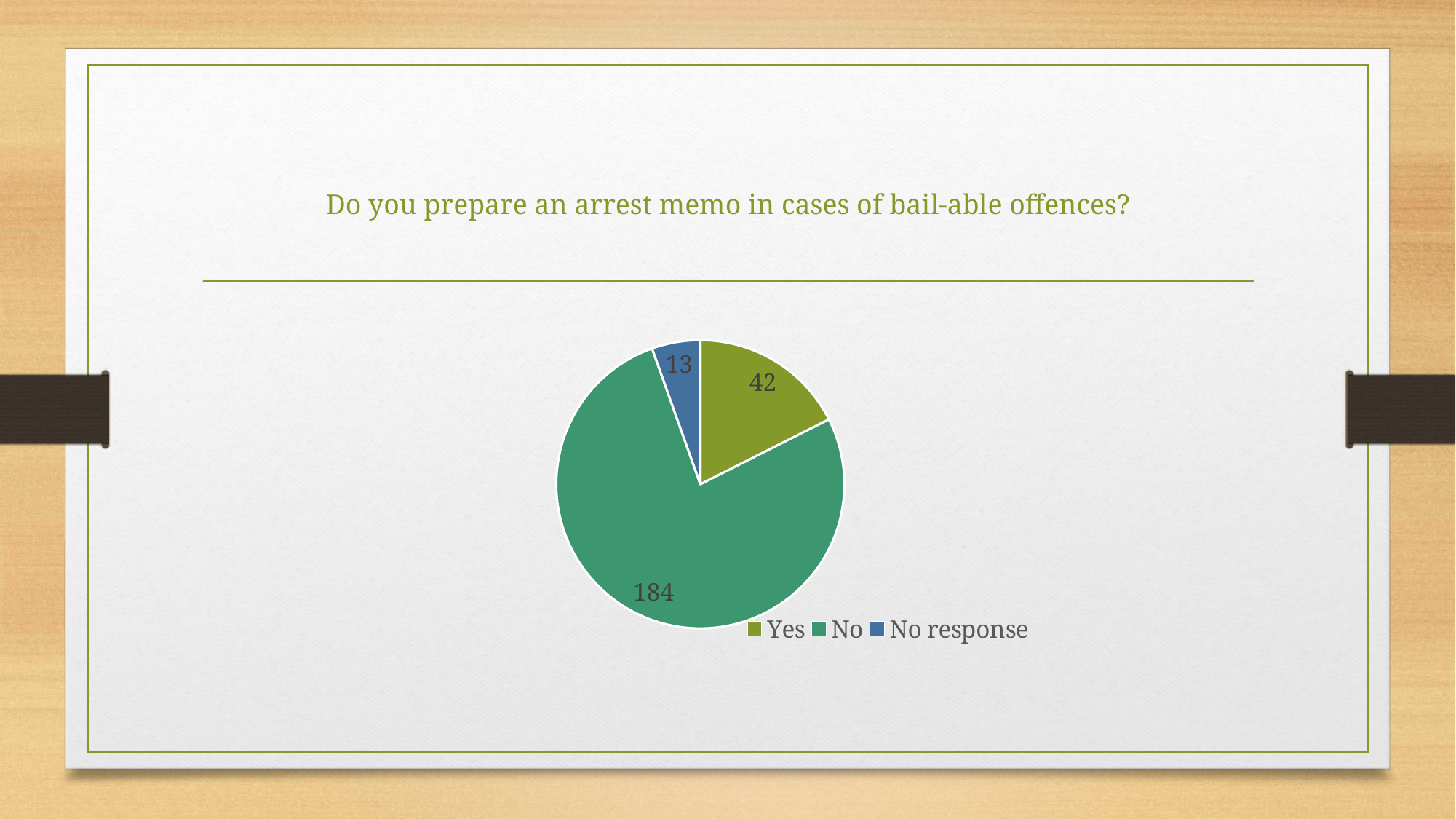
What is the title of the chart on the slide? Do you prepare an arrest memo in cases of bail-able offences? Which is larger, the value for "Yes" or the value for "No response"? Yes What is the value for "No" in the pie chart? 184 How many categories are shown in the pie chart? 3 What is the total of all the values in the pie chart? 239 What is the difference between the values for "Yes" and "No response"? 29 What kind of chart is shown on the slide? Pie chart What is the value for "No response" in the pie chart? 13 What is the difference between the values for "No" and "Yes"? 142 Which category has the smallest slice of the pie chart? No response What is the value for "Yes" in the pie chart? 42 Which category has the largest slice of the pie chart? No